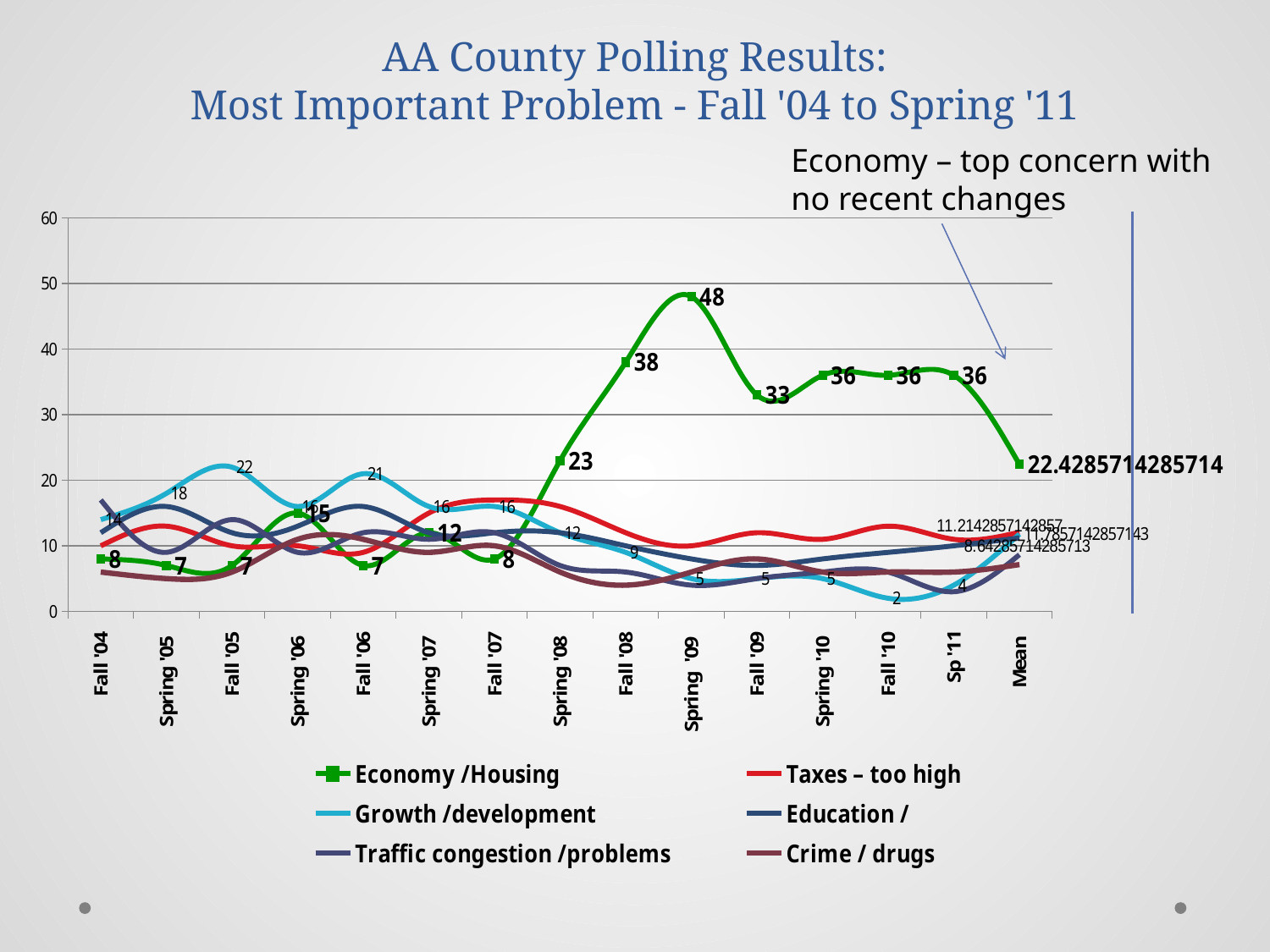
In which period does the Economy /Housing series reach its highest value? Spring '09 What is the Mean value shown for Economy /Housing? 22.4285714285714 How many series does the legend list? 6 Which is larger for Economy /Housing: the value in Fall '07 or the value in Spring '08? Spring '08 Is the value for Taxes – too high in Fall '07 greater or less than 10? greater What kind of chart is shown on the slide? line chart What is the value for Economy /Housing in Fall '08? 38 What is the value for Growth /development in Fall '05? 22 What is the difference between the Economy /Housing values for Spring '09 and Fall '08? 10 Does the Economy /Housing series rise or fall from Fall '07 to Spring '09? rise How many categories are shown along the x axis? 15 What is the value for Economy /Housing in Spring '09? 48